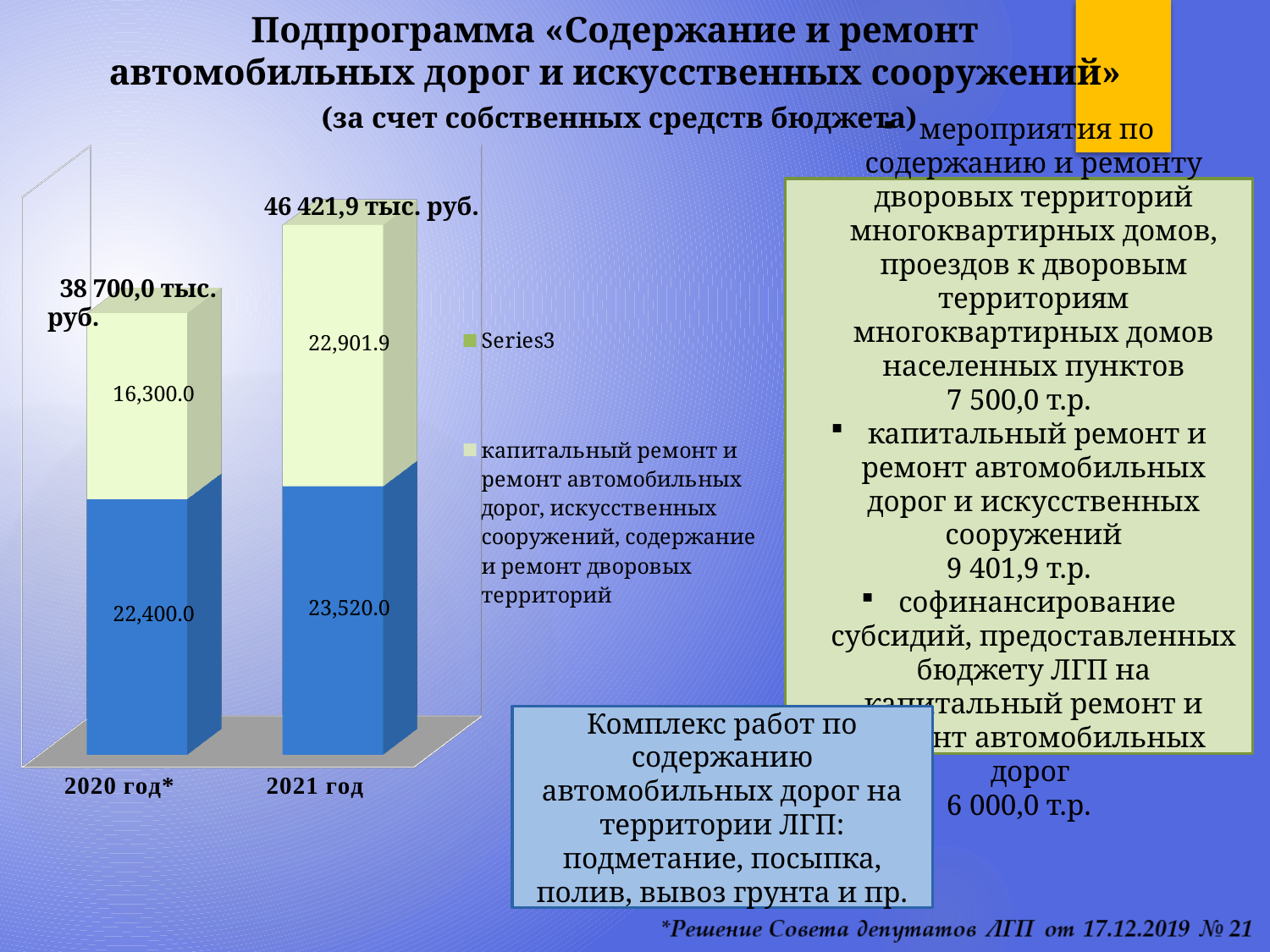
What is the total labelled above the bar for 2021 год? 46 421,9 тыс. руб. Which is larger: the light segment for 2021 год or the light segment for 2020 год*? 2021 год What is the total labelled above the bar for 2020 год*? 38 700,0 тыс. руб. What is the difference between the blue segment values for 2021 год and 2020 год*? 1,120.0 How many categories (years) are shown on the x axis of the chart? 2 What is the value of the blue segment for 2021 год? 23,520.0 Which year has the higher total bar value? 2021 год What type of chart is shown on the slide? bar chart What is the value of the light (upper) segment for 2021 год? 22,901.9 How many entries does the chart legend list? 2 What is the value of the blue segment for 2020 год*? 22,400.0 What is the value of the light (upper) segment for 2020 год*? 16,300.0